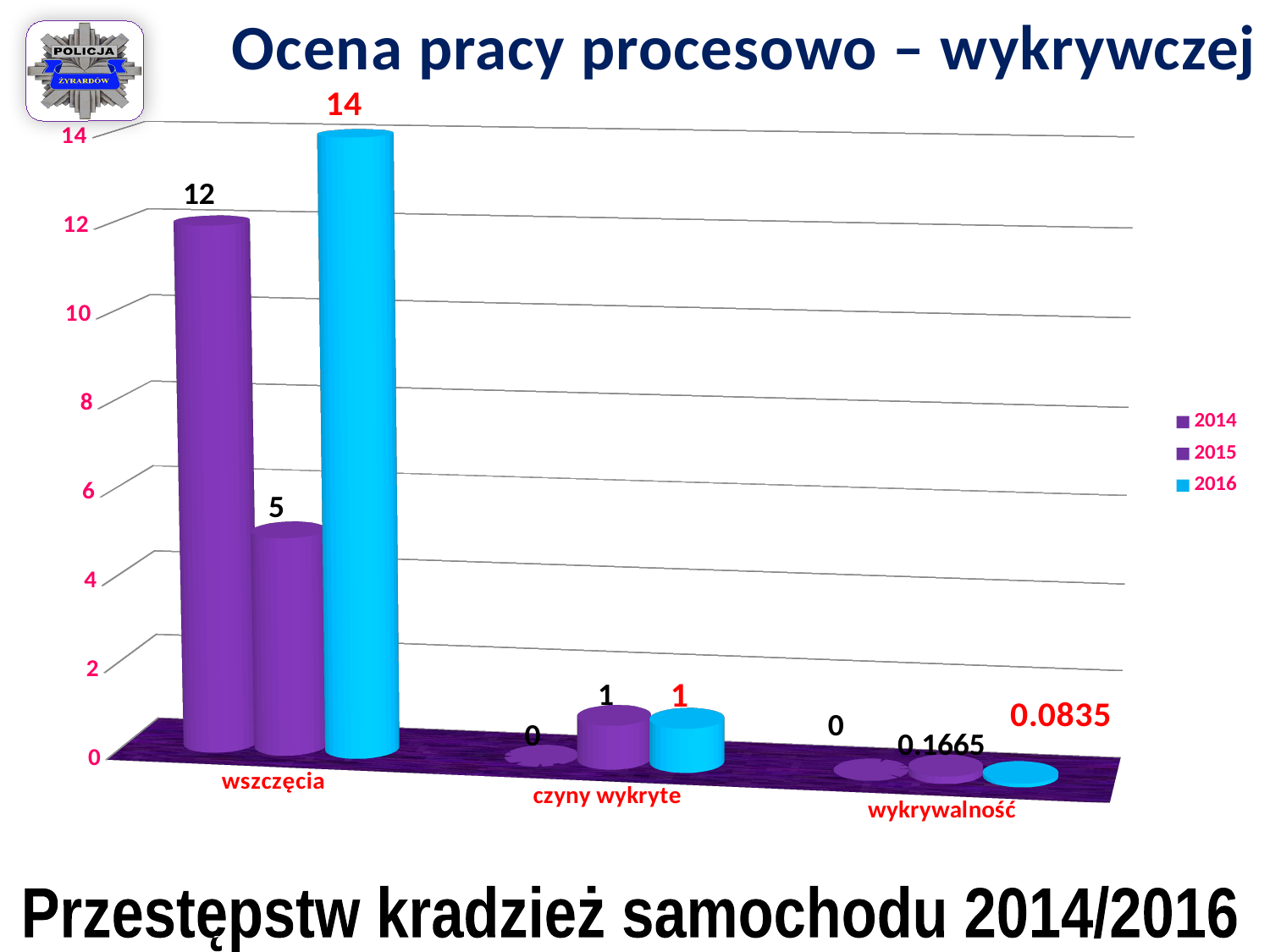
What is the value for 2016 in the wykrywalność category? 0.0835 What is the value for 2015 in the wszczęcia category? 5 What is the value for 2016 in the wszczęcia category? 14 What is the difference between the 2016 and 2014 values in the wszczęcia category? 2 How many series does the legend list? 3 Which is larger in the wszczęcia category, the 2014 value or the 2015 value? 2014 What is the value for 2014 in the wszczęcia category? 12 Which year has the lowest value in the wszczęcia category? 2015 What type of chart is shown on the slide? Bar chart What is the value for 2015 in the wykrywalność category? 0.1665 What is the value for 2014 in the czyny wykryte category? 0 Which year has the highest value in the wszczęcia category? 2016